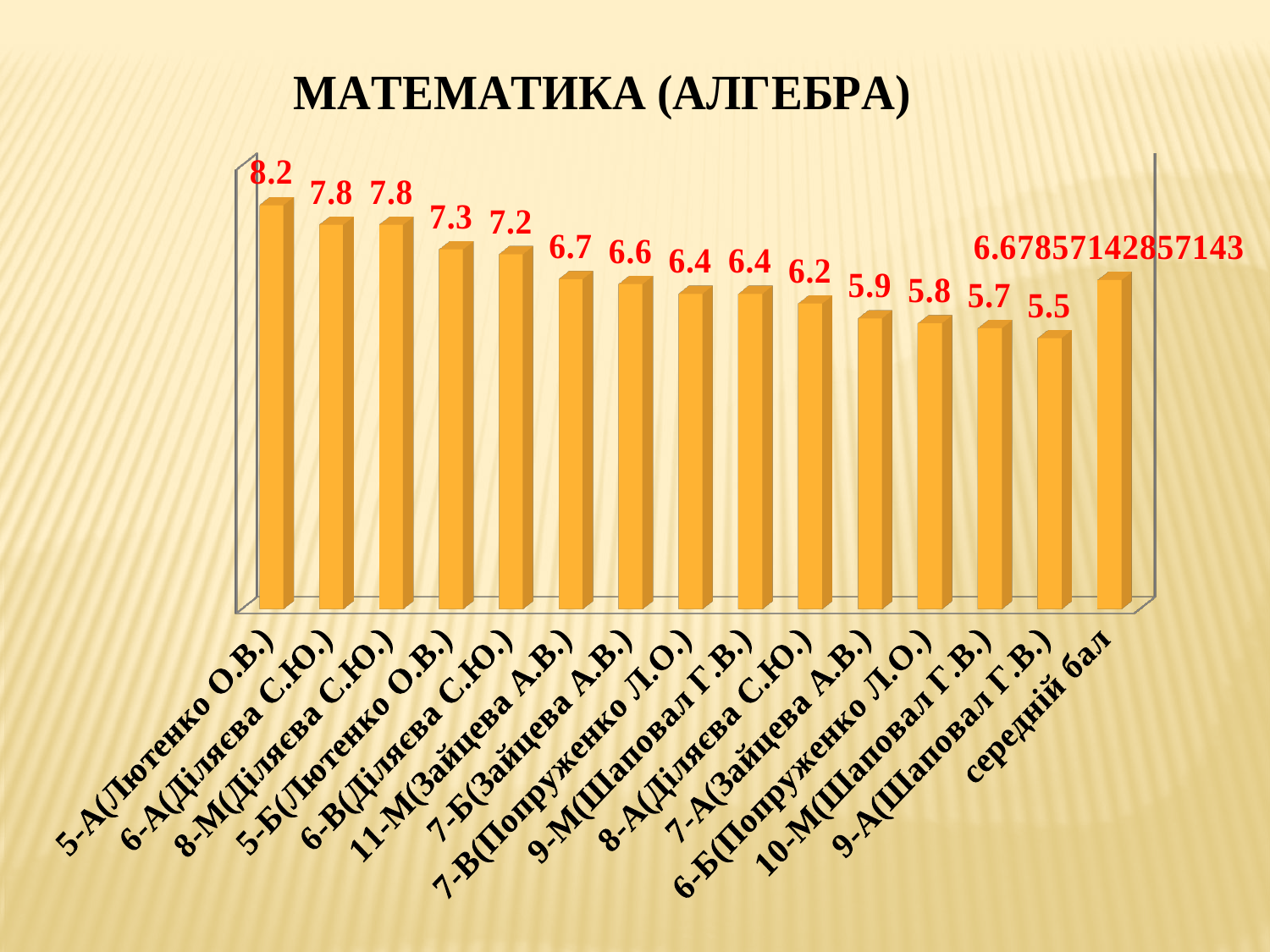
How many bars are shown in the chart? 15 What is the value for 11-М(Зайцева А.В.)? 6.7 Which category has the lowest value? 9-А(Шаповал Г.В.) What is the value for 9-А(Шаповал Г.В.)? 5.5 What kind of chart is shown on the slide? bar chart What is the value for 5-А(Лютенко О.В.)? 8.2 What is the value for середній бал? 6.67857142857143 Do the values of the class bars rise or fall from left to right (before the середній бал bar)? fall What is the title of the chart? МАТЕМАТИКА (АЛГЕБРА) Which is larger, the value for 5-Б(Лютенко О.В.) or the value for 8-А(Діляєва С.Ю.)? 5-Б(Лютенко О.В.) What is the difference between the values for 5-А(Лютенко О.В.) and 9-А(Шаповал Г.В.)? 2.7 Which category has the highest value? 5-А(Лютенко О.В.)